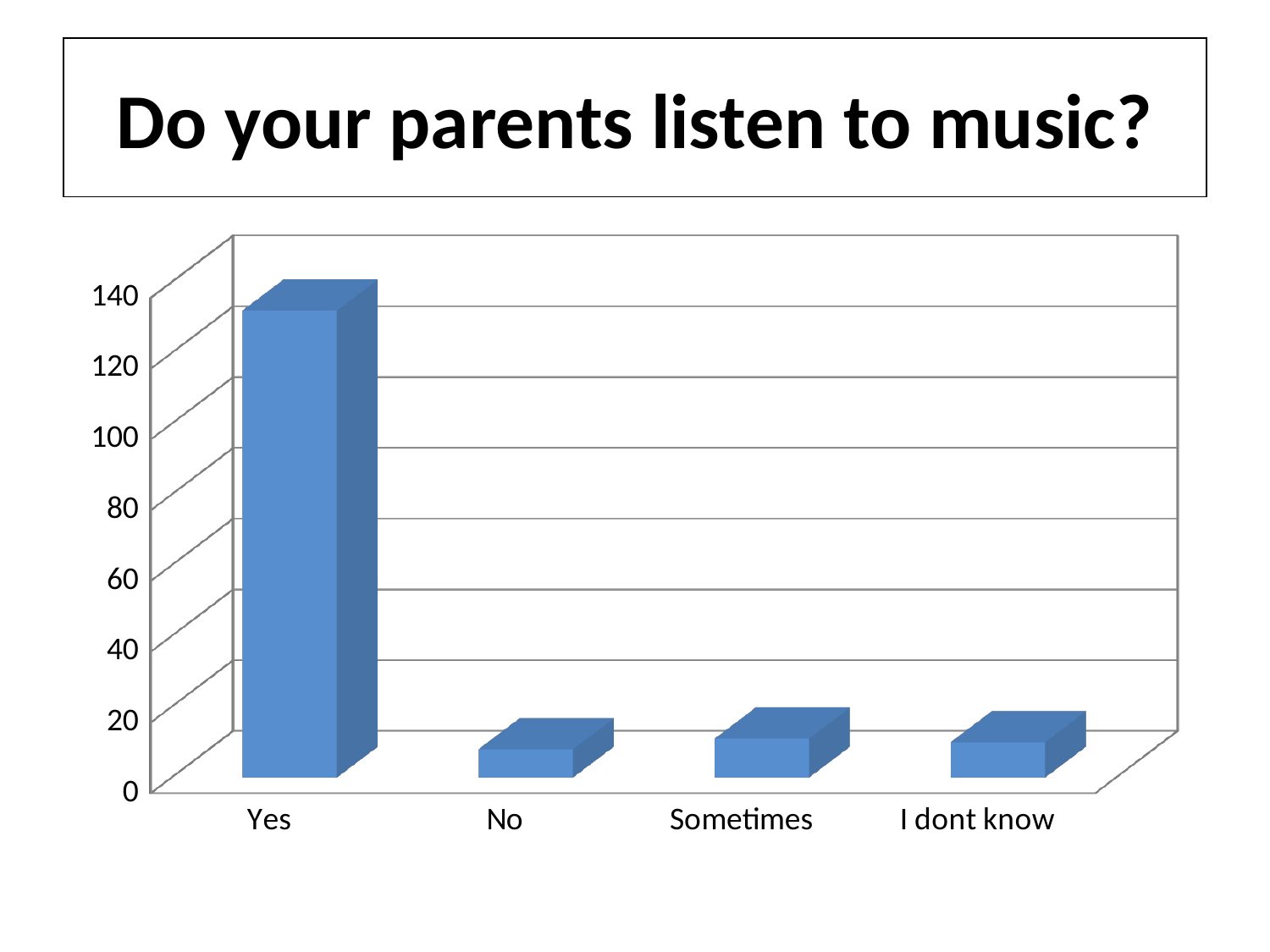
Which is larger, the value for Yes or the value for Sometimes? Yes Is the value for Yes greater or less than 120? greater What colour are the bars in the chart? blue How many categories are shown on the x axis of the chart? 4 What is the title of the slide above the chart? Do your parents listen to music? Is the value for No greater or less than 20? less Is the value for Yes greater or less than 140? less Which category has the highest value in the chart? Yes Which is larger, the value for Yes or the value for No? Yes What kind of chart is shown on the slide? bar chart